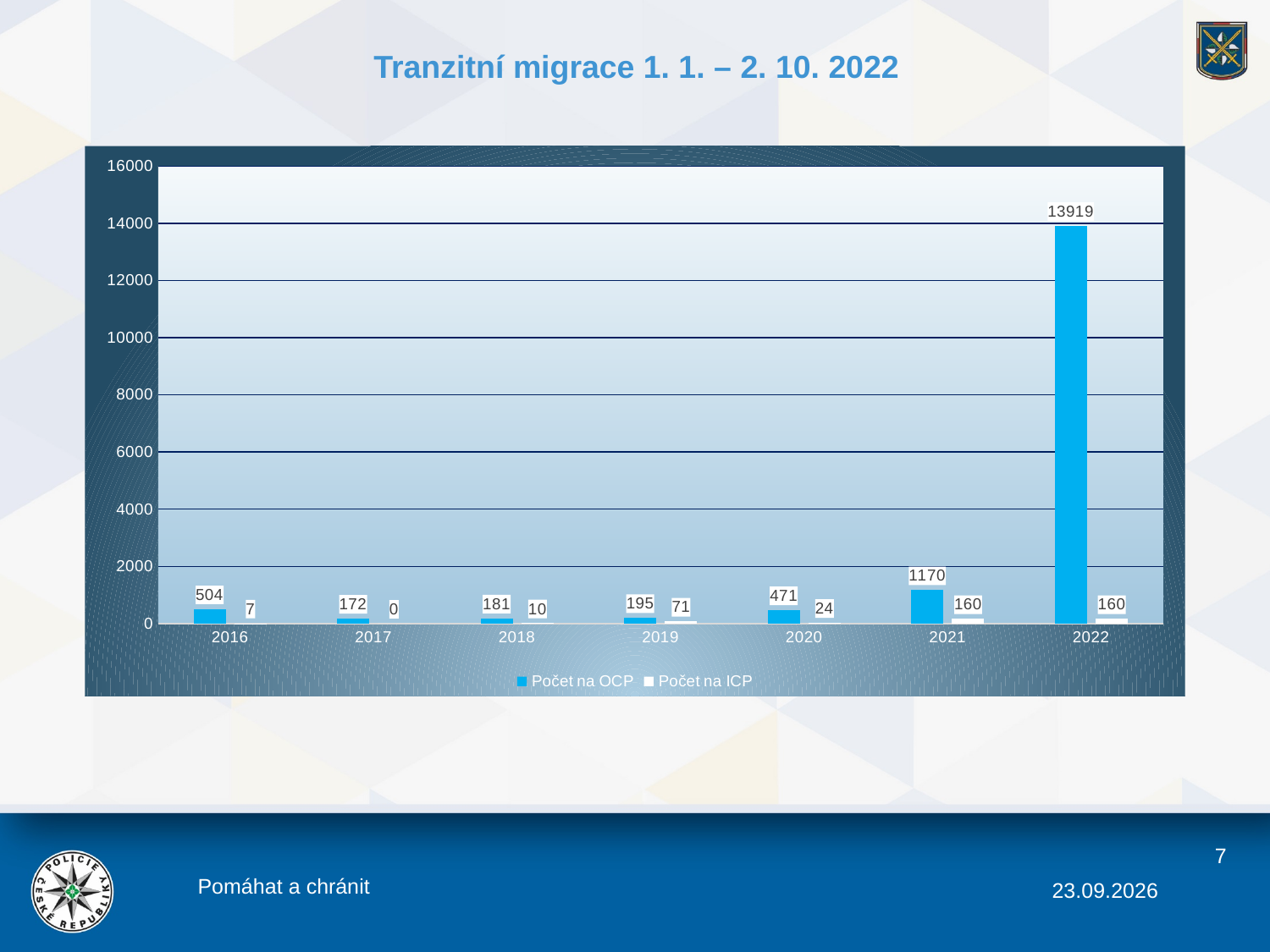
Which year has the lowest value for Počet na OCP? 2017 Which year has the highest value for Počet na OCP? 2022 How many years are shown on the x axis? 7 What is the difference between Počet na OCP in 2022 and in 2021? 12749 What is the value for Počet na ICP in 2017? 0 What is the value for Počet na ICP in 2019? 71 What kind of chart is shown on the slide? bar chart How many series does the legend list? 2 What is the value for Počet na OCP in 2021? 1170 What is the value for Počet na OCP in 2022? 13919 Which is larger, Počet na OCP in 2016 or Počet na OCP in 2020? Počet na OCP in 2016 Is the value for Počet na OCP in 2022 greater or less than 12000? greater